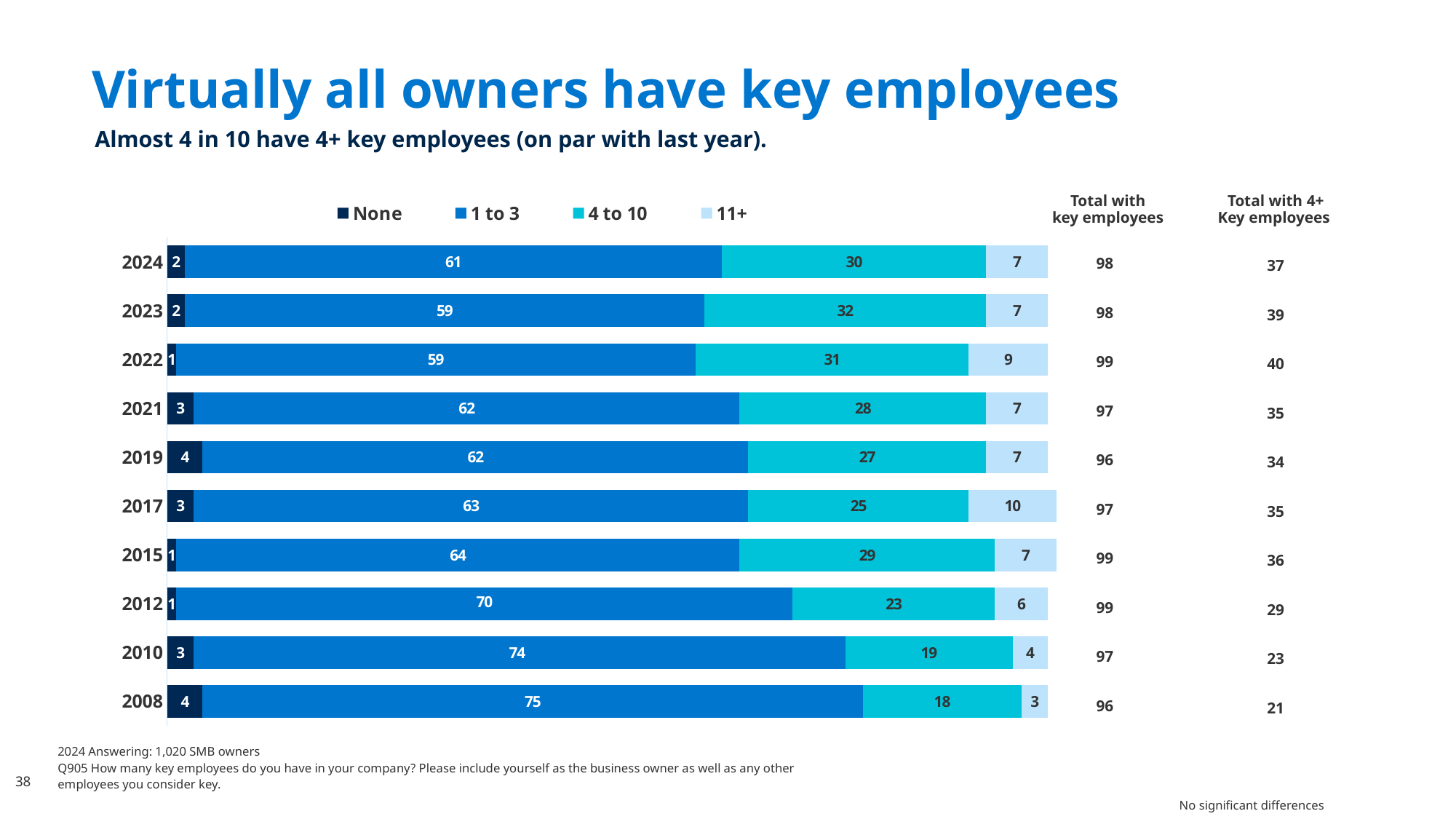
What is the difference between the "1 to 3" values for 2008 and 2024? 14 How many years are shown in the chart? 10 From 2008 to 2024, does the "1 to 3" value rise or fall? Fall What is the value for the "1 to 3" segment in 2024? 61 What kind of chart is shown on the slide? Stacked bar chart What is the total of the stacked bar for 2024? 100 Which year has the highest value for the "1 to 3" segment? 2008 Which year has the larger "4 to 10" value, 2023 or 2024? 2023 What is the value for the "11+" segment in 2017? 10 Which year has the lowest value for the "4 to 10" segment? 2008 How many series does the legend list? 4 What is the value for the "4 to 10" segment in 2022? 31